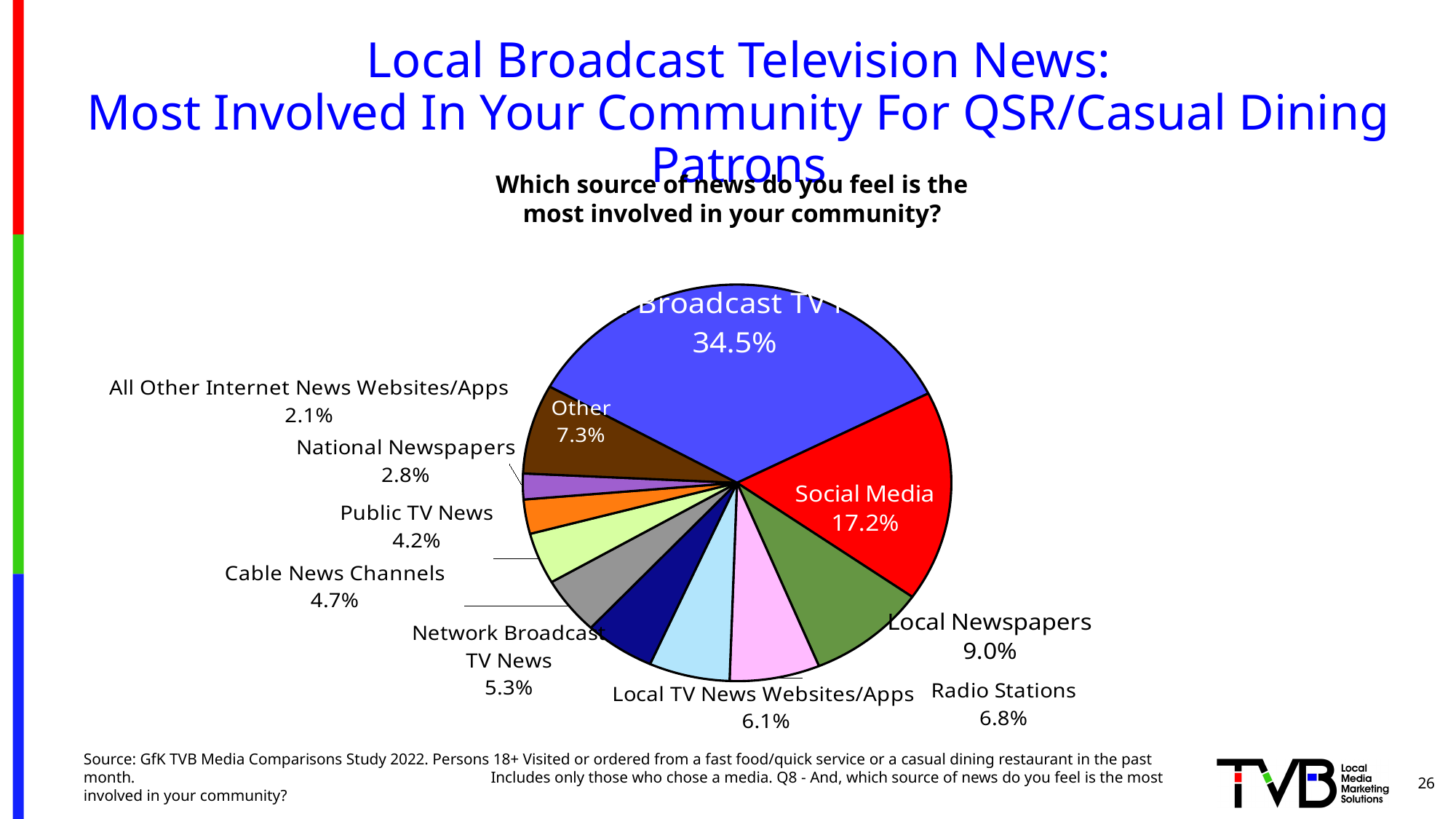
What is the difference between the values for Social Media and Local Newspapers? 8.2% What share of the pie does Social Media account for? 17.2% What is the value of the largest slice in the pie chart? 34.5% What is the value shown for All Other Internet News Websites/Apps? 2.1% What is the value shown for Radio Stations? 6.8% What is the value shown for Cable News Channels? 4.7% What question is the pie chart answering, according to the text above it? Which source of news do you feel is the most involved in your community? What kind of chart is shown on the slide? pie chart What is the value shown for Local Newspapers? 9.0% Which category has the smallest slice in the pie chart? All Other Internet News Websites/Apps Which is larger, the value for Public TV News or the value for Network Broadcast TV News? Network Broadcast TV News How many slices does the pie chart have? 11